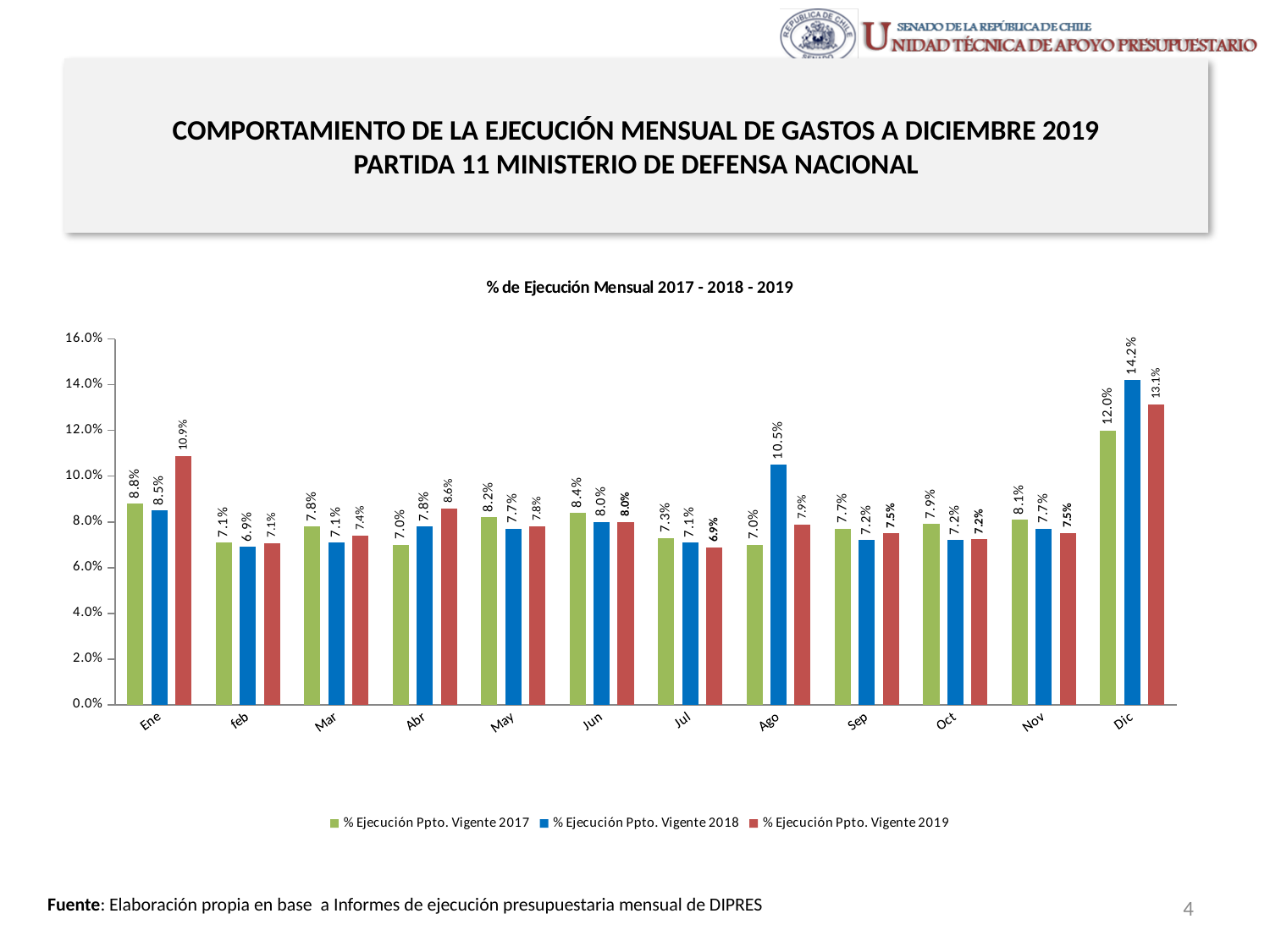
Which is larger in Abr: the 2017 value or the 2019 value? 2019 value (8.6%) What is the value for % Ejecución Ppto. Vigente 2017 in Dic? 12.0% What is the difference between the 2018 and 2017 values in Dic? 2.2% What kind of chart is shown on the slide? Bar chart How many months are shown on the x axis? 12 How many series does the legend list? 3 In which month is the % Ejecución Ppto. Vigente 2019 series lowest? Jul In which month is the % Ejecución Ppto. Vigente 2018 series highest? Dic Is the value for % Ejecución Ppto. Vigente 2018 in Dic greater or less than 14.0%? greater What is the title of the chart? % de Ejecución Mensual 2017 - 2018 - 2019 What is the value for % Ejecución Ppto. Vigente 2018 in Ago? 10.5% What is the value for % Ejecución Ppto. Vigente 2019 in Ene? 10.9%